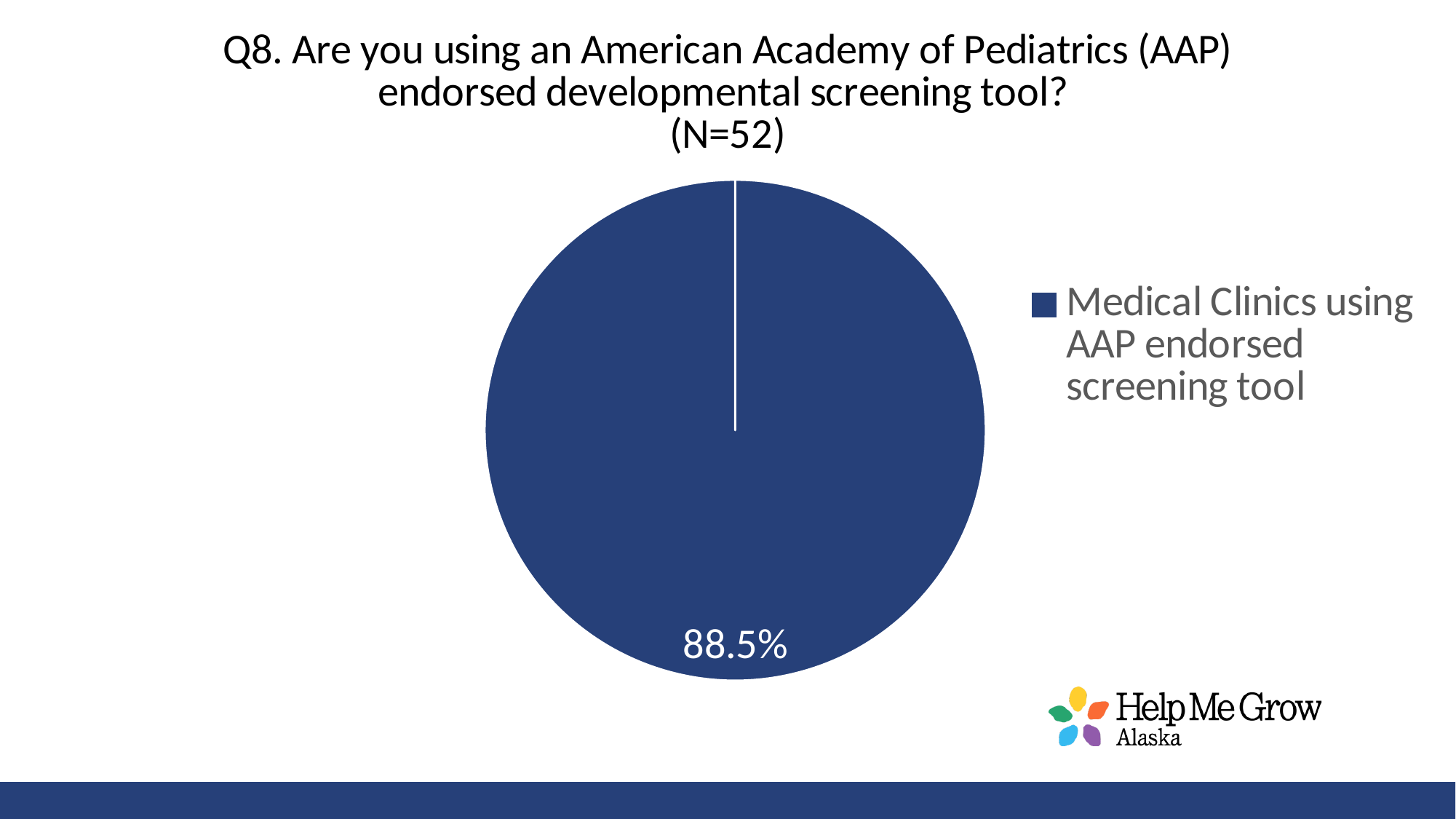
What kind of chart is shown on the slide? pie chart What is the legend entry for the pie chart? Medical Clinics using AAP endorsed screening tool How many slices in the pie have a printed data label? 1 Is the value for Medical Clinics using AAP endorsed screening tool greater or less than 50%? greater How many entries does the legend list? 1 What is the sample size (N) stated in the chart title? N=52 What percentage is shown for Medical Clinics using AAP endorsed screening tool? 88.5% What share of the pie does the labelled slice represent? 88.5%